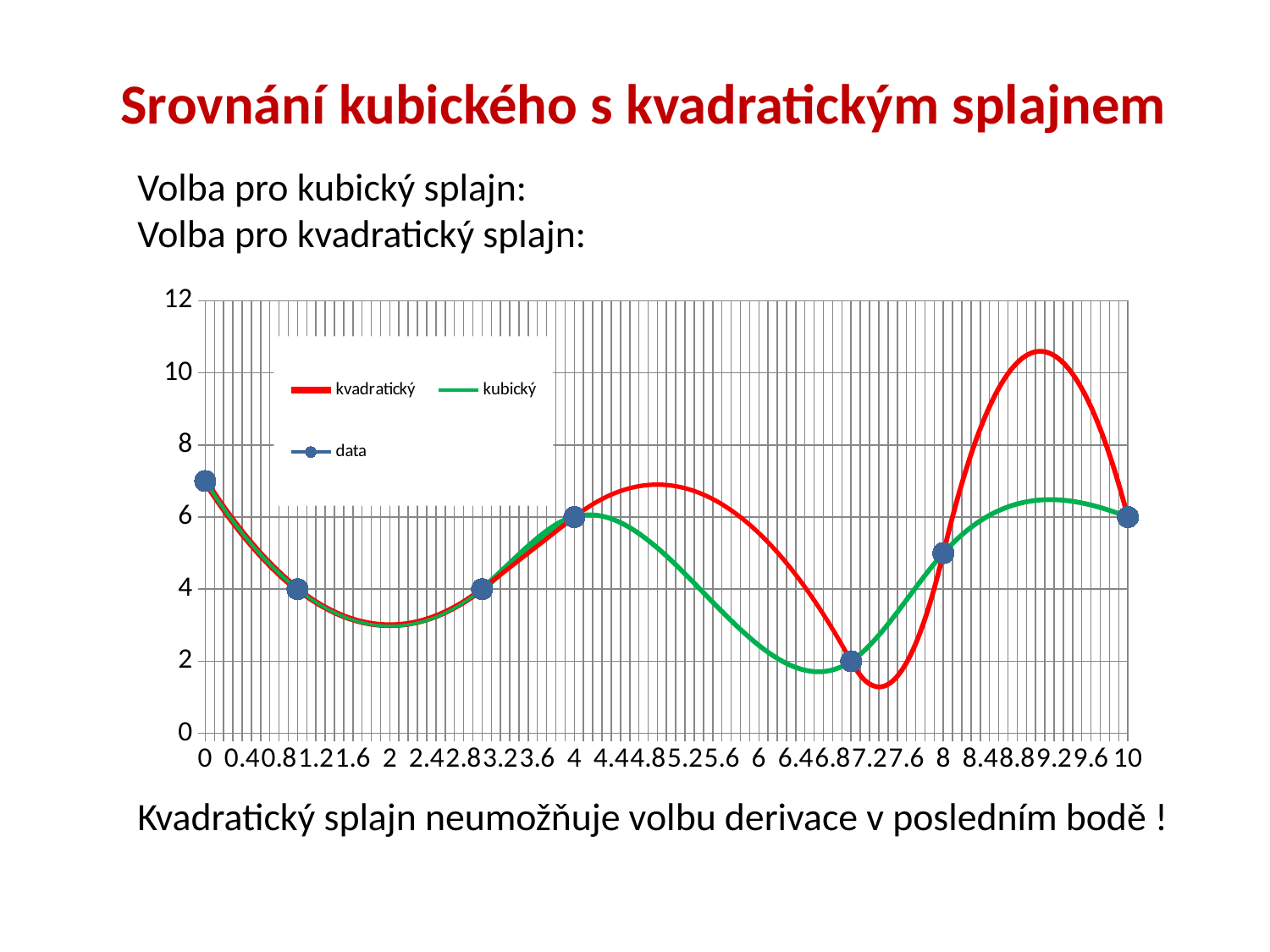
Is the value of the kvadratický series at x = 9 greater or less than 8? greater What is the value of the data series at x = 4? 6 At which x value does the data series reach its lowest value? 7 What kind of chart is shown on the slide? line chart At x = 5, which series has the higher value, kvadratický or kubický? kvadratický What colour is the kvadratický series drawn in? red How many data points are plotted in the data series? 7 At which x value does the data series reach its highest value? 0 How many series does the legend list? 3 What are the three series named in the legend? kvadratický, kubický, data What is the value of the data series at x = 10? 6 What is the value of the data series at x = 7? 2